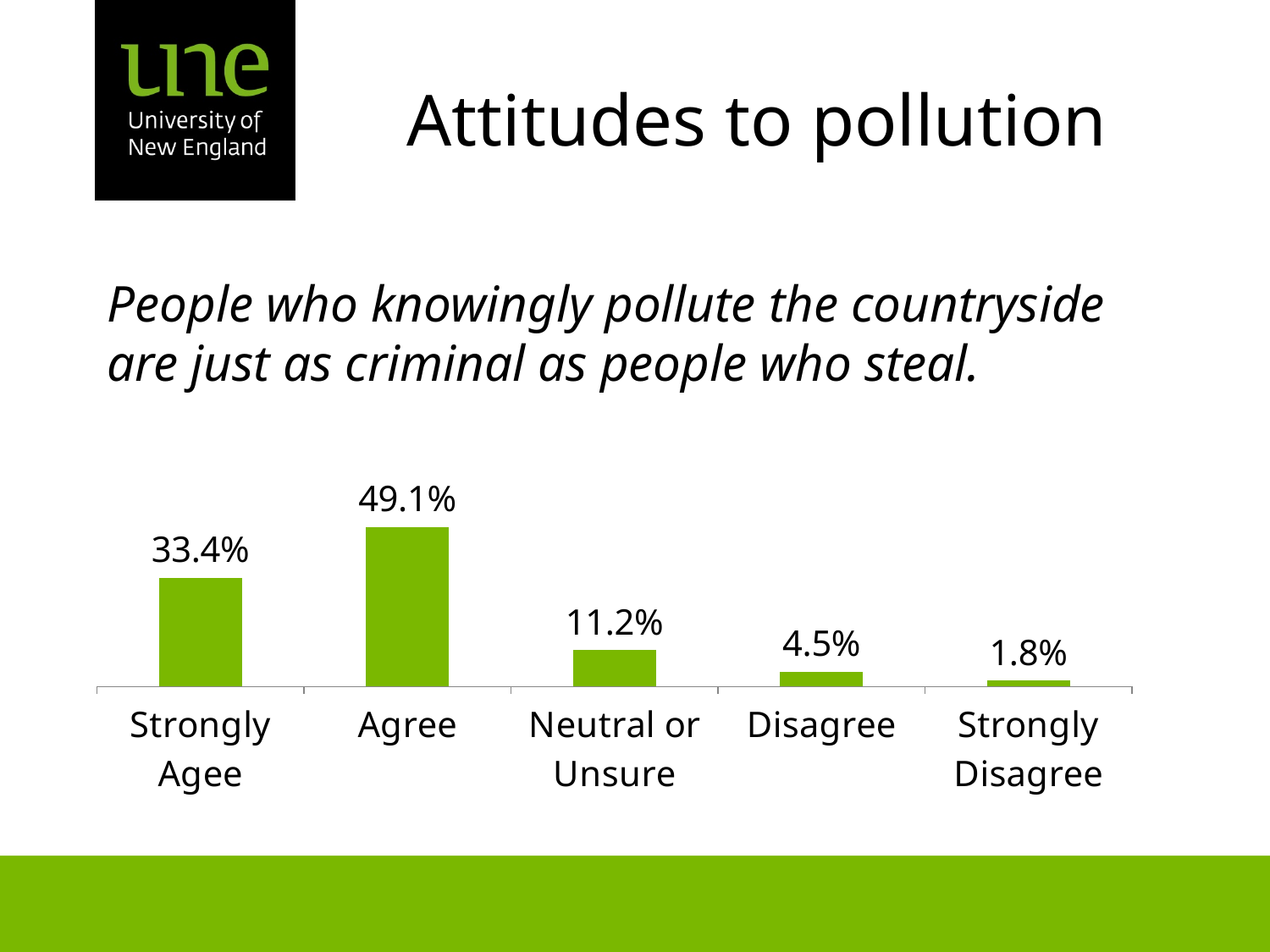
What is the value for Strongly Disagree? 1.8% What colour are the bars in the chart? Green What percentage is shown for Neutral or Unsure? 11.2% Which category has the lowest value? Strongly Disagree Which category has the highest value? Agree What is the value shown for Strongly Agee? 33.4% What is the difference between the Disagree and Strongly Disagree values? 2.7% Which is larger, the value for Neutral or Unsure or the value for Disagree? Neutral or Unsure How many categories are shown on the x axis? 5 What percentage of respondents chose Agree? 49.1% What is the difference between the Agree and Strongly Agee values? 15.7% What kind of chart is shown on the slide? Bar chart